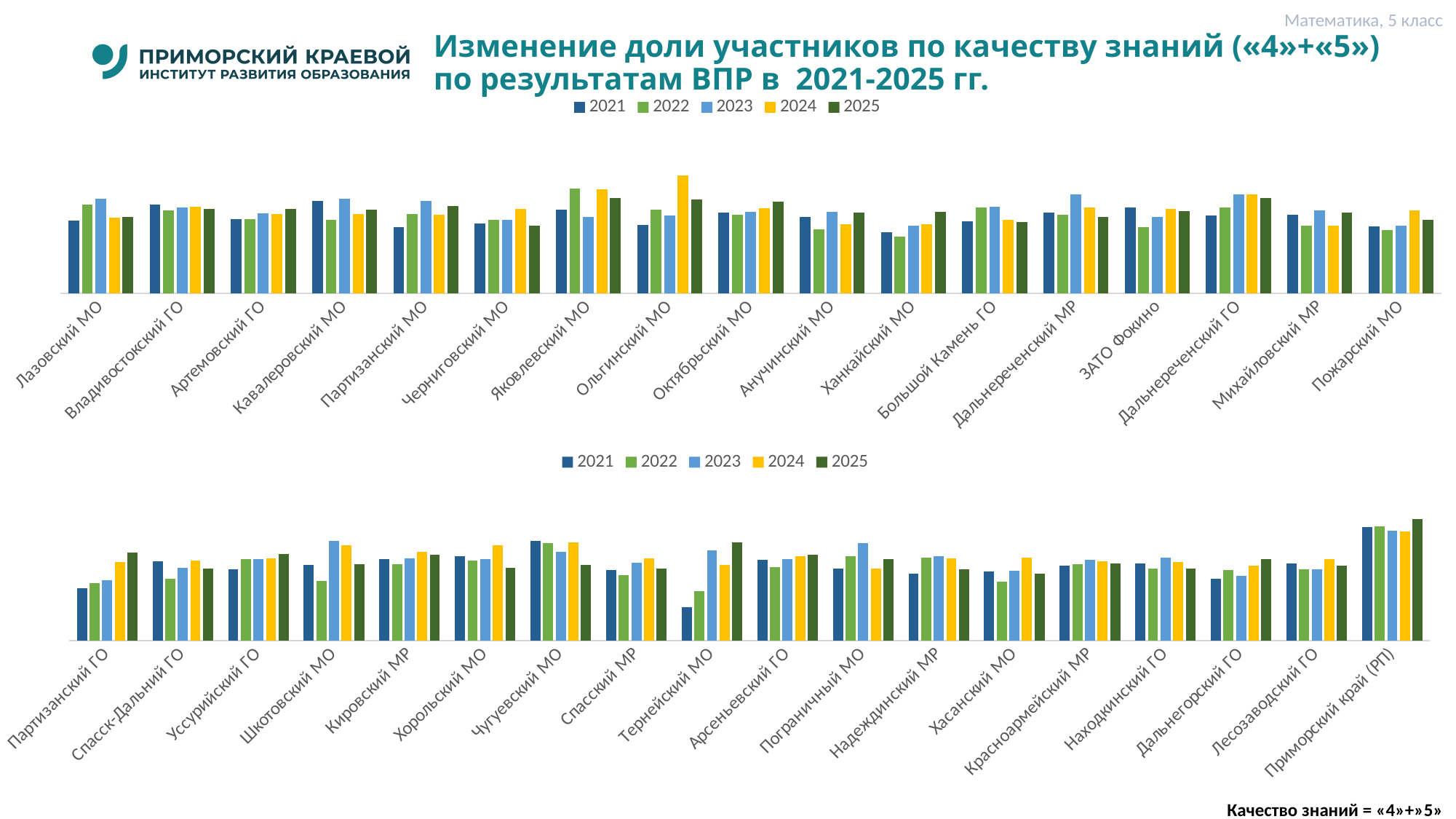
How many categories are shown on the x axis of the bottom chart? 18 In the bottom chart, do the values for Партизанский ГО rise or fall from 2021 to 2025? rise Which years are listed in the legend of the bottom chart? 2021, 2022, 2023, 2024, 2025 In the top chart, which year has the highest bar for Ольгинский МО? 2024 In the bottom chart, which year has the lowest bar for Тернейский МО? 2021 What kind of chart is the top chart on the slide? bar chart How many municipalities are shown on the x axis of the top chart? 17 In the bottom chart, which is larger for Тернейский МО: the 2021 value or the 2025 value? 2025 In the bottom chart, which year has the highest bar for Партизанский ГО? 2025 In the bottom chart, which year has the lowest bar for Шкотовский МО? 2022 How many series does the legend of the top chart list? 5 In the top chart, which is larger for Яковлевский МО: the 2021 value or the 2022 value? 2022